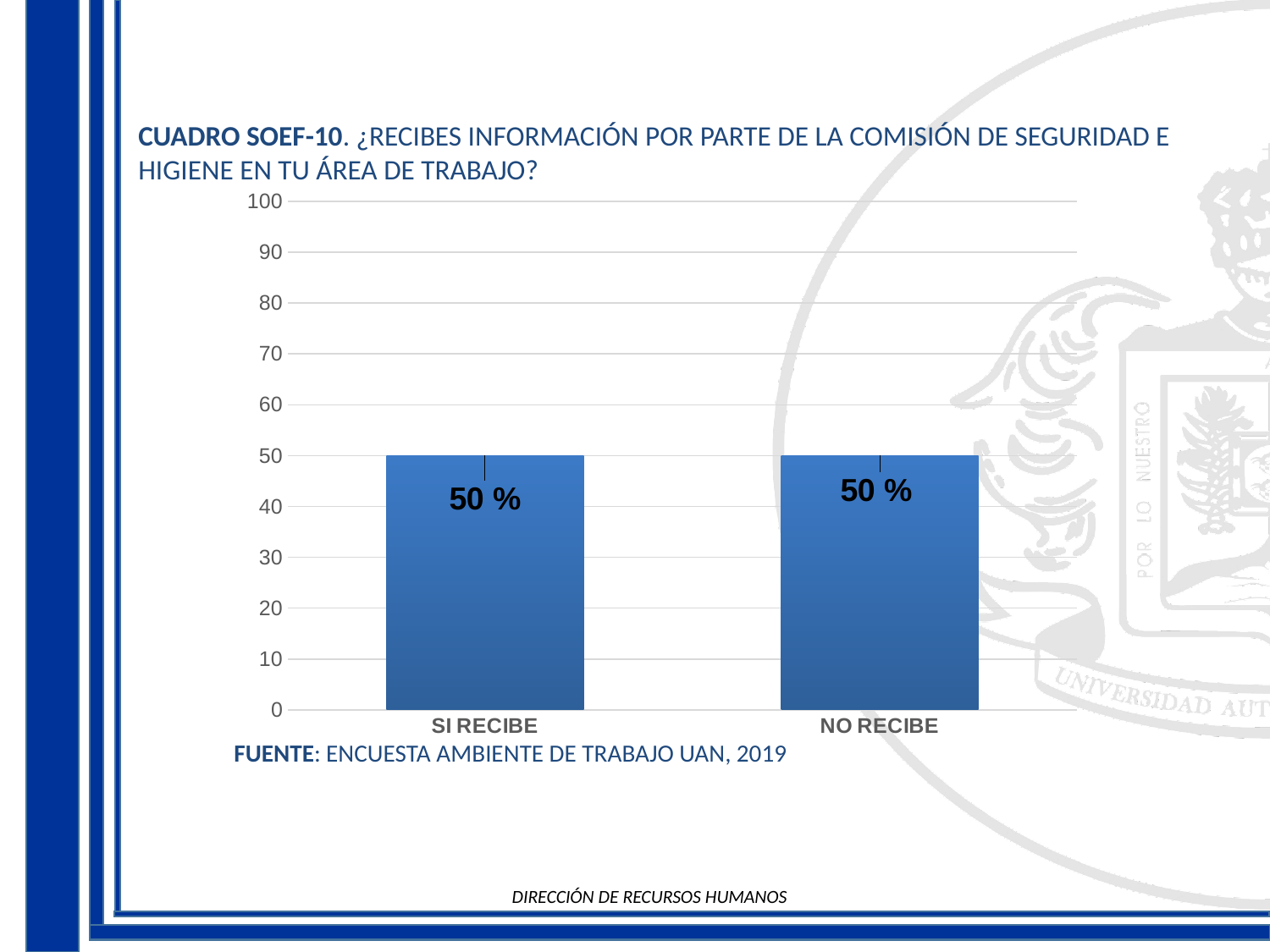
What is the difference between the values for SI RECIBE and NO RECIBE? 0 What source is cited below the chart? ENCUESTA AMBIENTE DE TRABAJO UAN, 2019 Is the value for SI RECIBE greater or less than 60? less How many categories are shown on the x axis? 2 What is the total of the two bars' values? 100 % What is the maximum value shown on the y axis? 100 What is the value for NO RECIBE? 50 % What is the value for SI RECIBE? 50 % What kind of chart is shown on the slide? bar chart Is the value for NO RECIBE greater or less than 40? greater